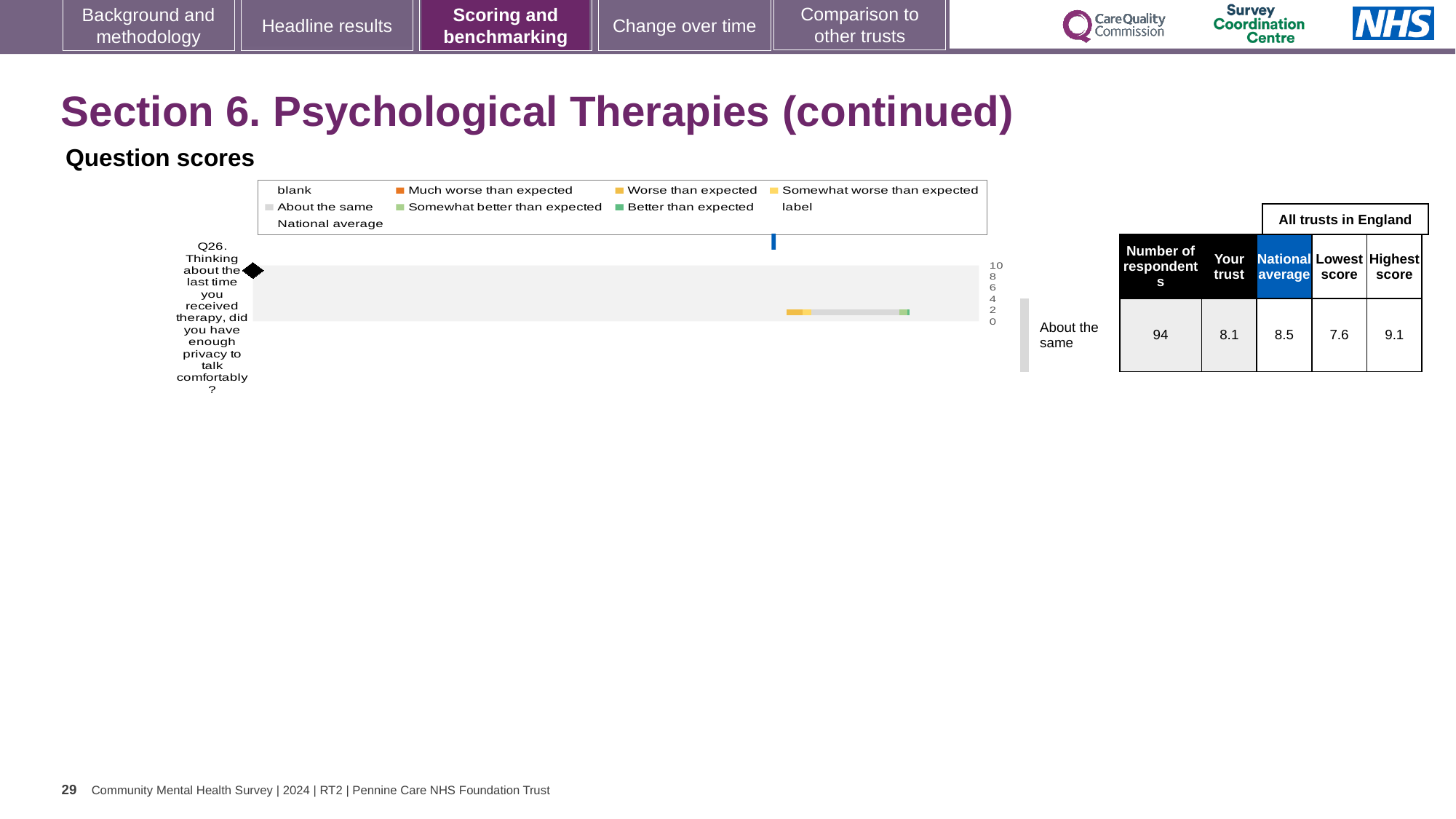
By how much does the national average exceed the 'Your trust' score for Q26? 0.4 What is the 'Your trust' score for Q26? 8.1 Which benchmark category is the trust's Q26 score placed in? About the same What is the difference between the highest score and the lowest score for Q26? 1.5 What is the lowest score among all trusts in England for Q26? 7.6 What is the maximum value shown on the chart's score axis? 10 How many survey questions are plotted on the chart? 1 What kind of chart is used to show the Q26 question score? bar chart How many respondents answered Q26? 94 What is the highest score among all trusts in England for Q26? 9.1 Which is larger for Q26, the 'Your trust' score or the national average? National average What is the national average score for Q26? 8.5